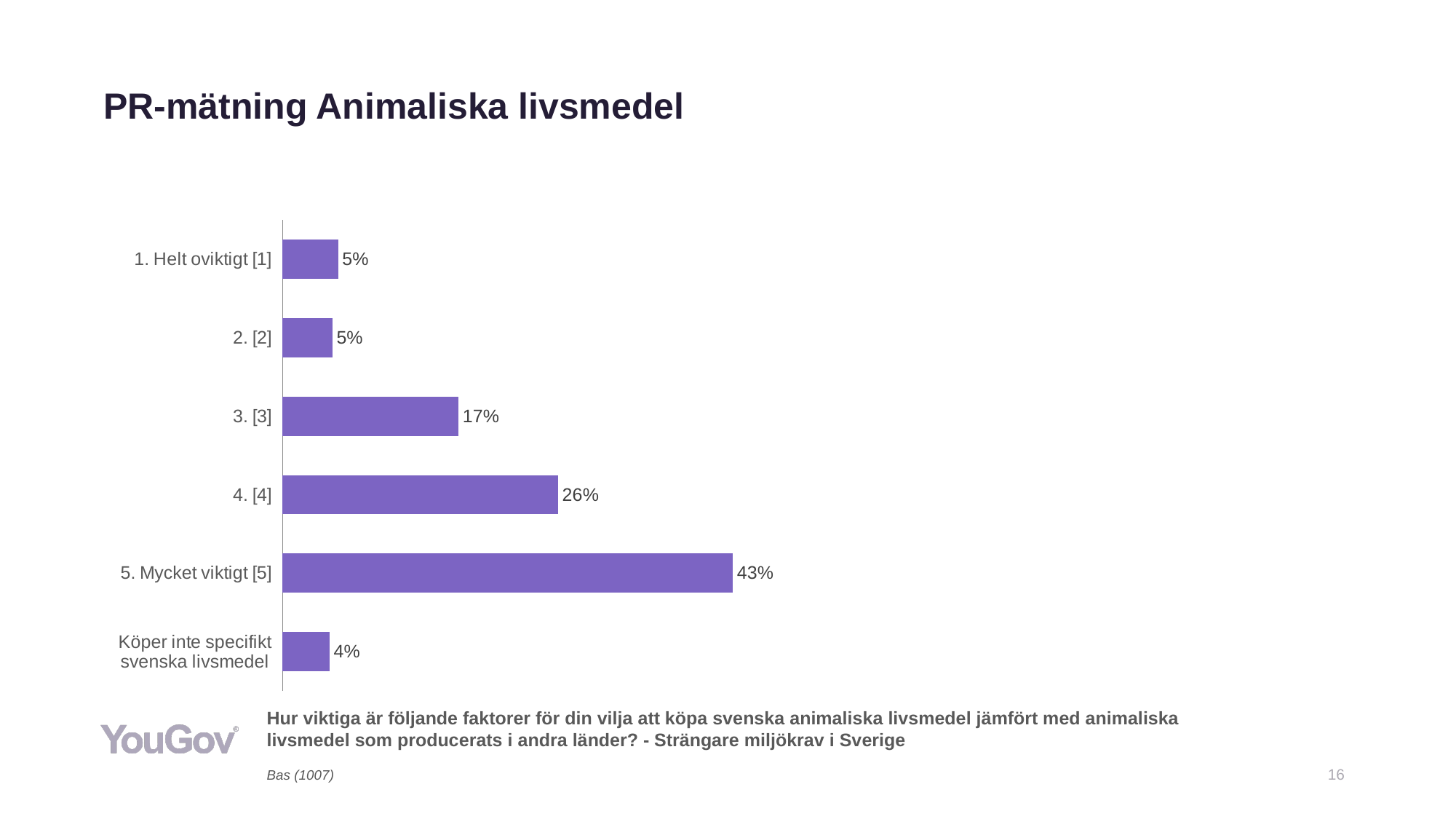
What is the value for "Köper inte specifikt svenska livsmedel"? 4% What is the difference between the values for "3. [3]" and "1. Helt oviktigt [1]"? 12% What is the title of the slide? PR-mätning Animaliska livsmedel What is the value for "4. [4]"? 26% What is the difference between the values for "5. Mycket viktigt [5]" and "4. [4]"? 17% How many categories are shown in the chart? 6 What kind of chart is shown on the slide? Bar chart What is the value for "5. Mycket viktigt [5]"? 43% Which category has the lowest value? Köper inte specifikt svenska livsmedel Which is larger, the value for "4. [4]" or the value for "3. [3]"? 4. [4] What is the value for "3. [3]"? 17% Which category has the highest value? 5. Mycket viktigt [5]